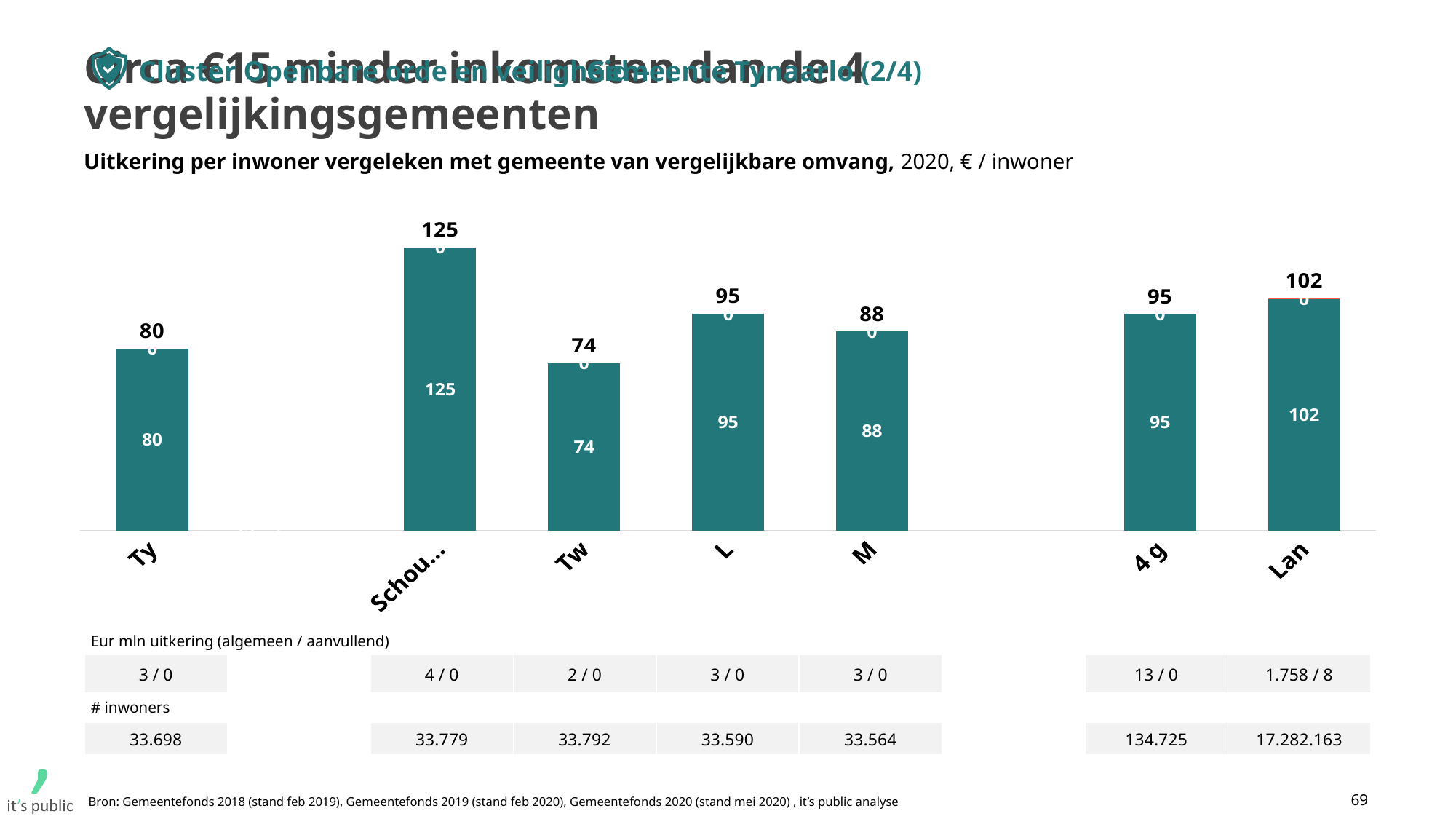
How many bars are shown in the chart? 7 Which category has the lowest value? Tw What is the value for the bar labelled "Schou..."? 125 What is the value for the bar labelled "Tw"? 74 What is the value for the bar labelled "Ty"? 80 Which is larger, the value for "M" or the value for "L"? L What is the value for the bar labelled "Lan"? 102 What unit is stated in the chart subtitle for the plotted values? € / inwoner What is the difference between the values for "Schou..." and "Ty"? 45 What kind of chart is shown on the slide? Bar chart Which category has the highest value? Schou... What is the difference between the values for "Lan" and "4 g"? 7